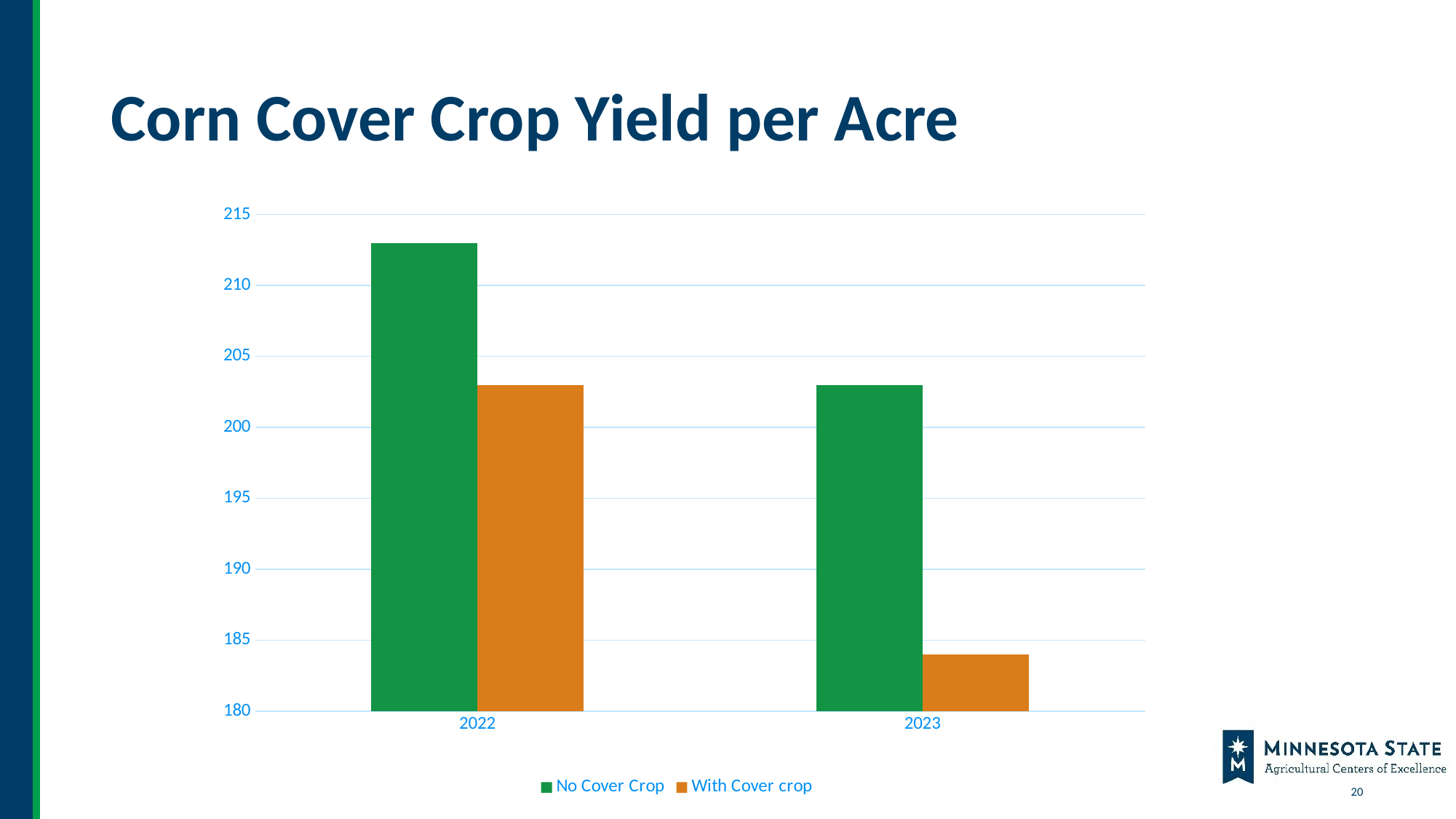
How many series does the legend list? 2 In 2023, which is larger: No Cover Crop or With Cover crop? No Cover Crop How many years are shown on the x axis? 2 Is the value for With Cover crop in 2023 greater or less than 185? less What is the title of the chart? Corn Cover Crop Yield per Acre Does the No Cover Crop yield rise or fall from 2022 to 2023? fall Which series has the highest bar on the chart? No Cover Crop In 2022, which is larger: No Cover Crop or With Cover crop? No Cover Crop What kind of chart is shown on the slide? bar chart Which bar is the lowest on the chart? With Cover crop in 2023 Is the value for No Cover Crop in 2023 greater or less than 200? greater Is the value for No Cover Crop in 2022 greater or less than 210? greater